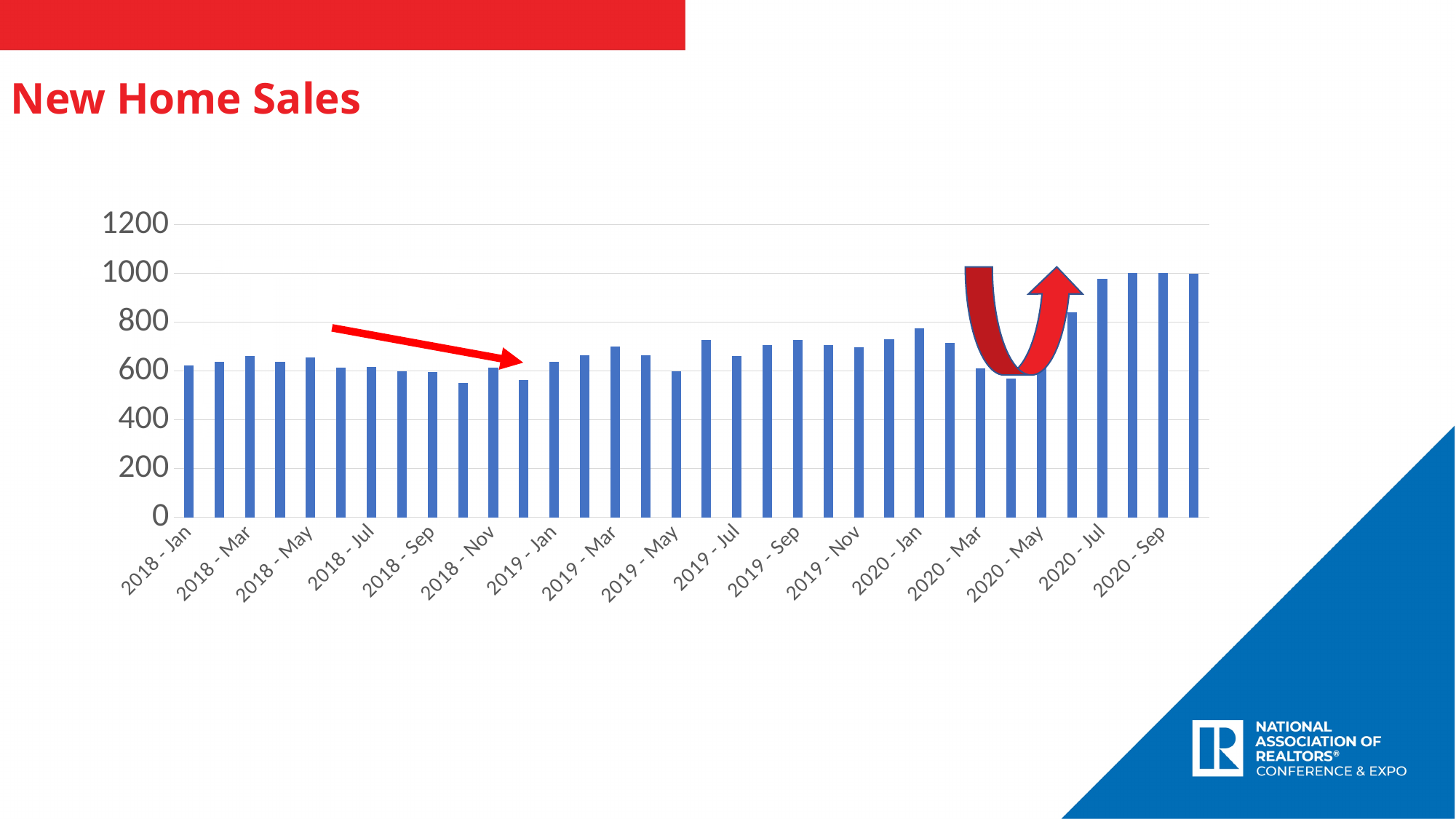
What kind of chart is shown on the slide? bar chart Which is larger, the value for 2020 - Jul or the value for 2018 - Jan? 2020 - Jul What is the highest value shown on the vertical axis of the chart? 1200 Is the value for 2019 - Jul greater or less than 600? greater Is the value for 2020 - Jul greater or less than 800? greater Is the value for 2018 - Mar greater or less than 800? less What is the title of the slide containing the chart? New Home Sales Which is larger, the value for 2019 - Jul or the value for 2018 - Nov? 2019 - Jul Do the values rise or fall from 2020 - May to 2020 - Sep? rise Do the values generally rise or fall from 2018 - Mar to 2018 - Nov? fall